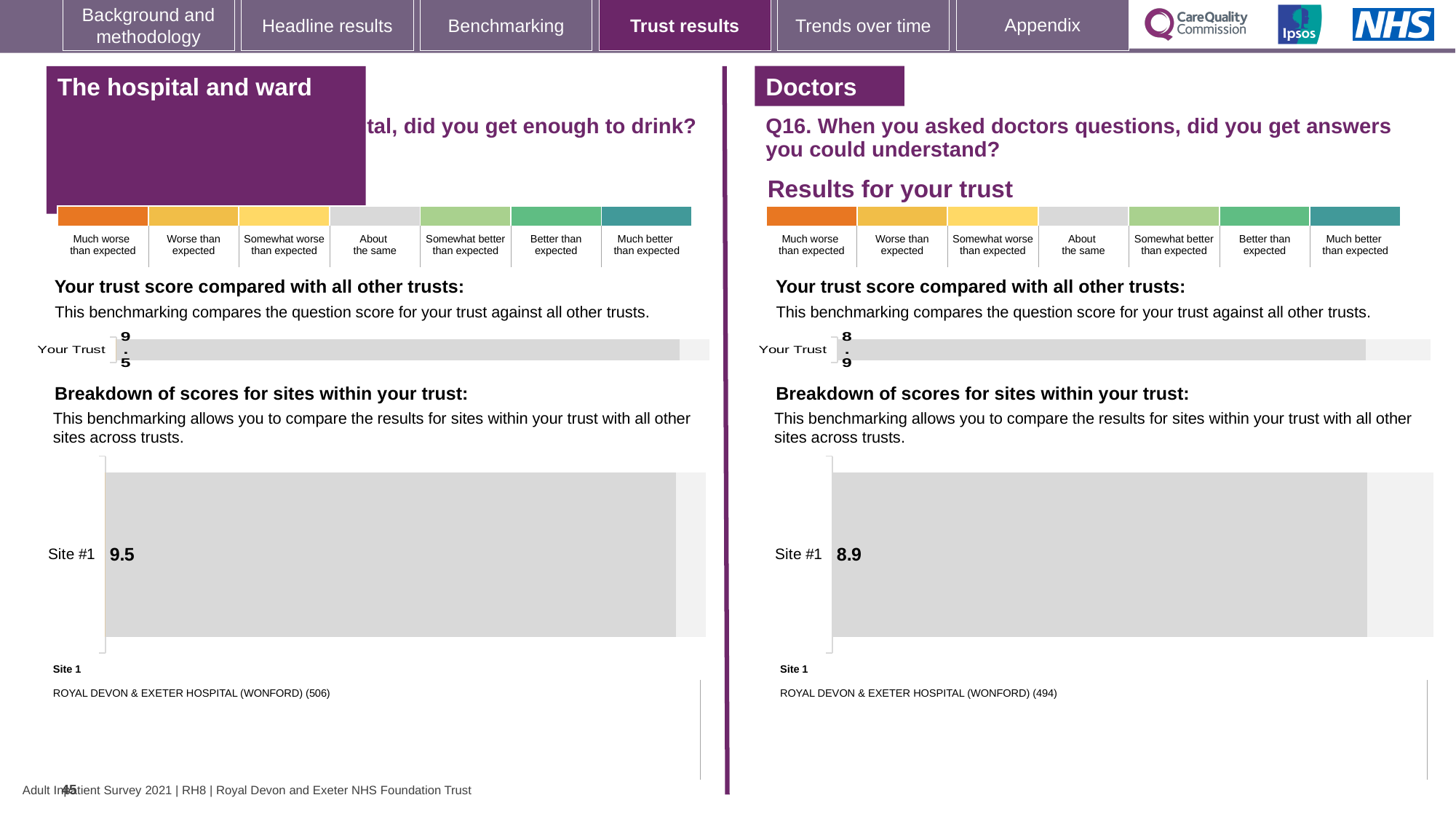
What kind of chart is used for the site breakdown on the left-hand section? Bar chart In the right-hand Q16 site breakdown chart, what score is shown for Site #1? 8.9 Which site is listed as Site 1 beneath the right-hand Q16 breakdown chart? ROYAL DEVON & EXETER HOSPITAL (WONFORD) (494) In the left-hand site breakdown chart, what score is shown for Site #1? 9.5 Which site is listed as Site 1 beneath the left-hand breakdown chart? ROYAL DEVON & EXETER HOSPITAL (WONFORD) (506) Which is larger: the Site #1 score in the left-hand chart or the Site #1 score in the right-hand Q16 chart? The left-hand chart (9.5) How many sites are shown in the left-hand site breakdown chart? 1 On the right-hand 'Doctors' section (Q16), what is the 'Your Trust' score shown in the trust comparison chart? 8.9 On the left-hand 'The hospital and ward' section, what is the 'Your Trust' score shown in the trust comparison chart? 9.5 What is the difference between the Site #1 score in the left-hand chart (9.5) and the Site #1 score in the right-hand Q16 chart (8.9)? 0.6 What kind of chart is used for the 'Your Trust' score comparison on the right-hand Q16 section? Bar chart How many sites are shown in the right-hand Q16 site breakdown chart? 1